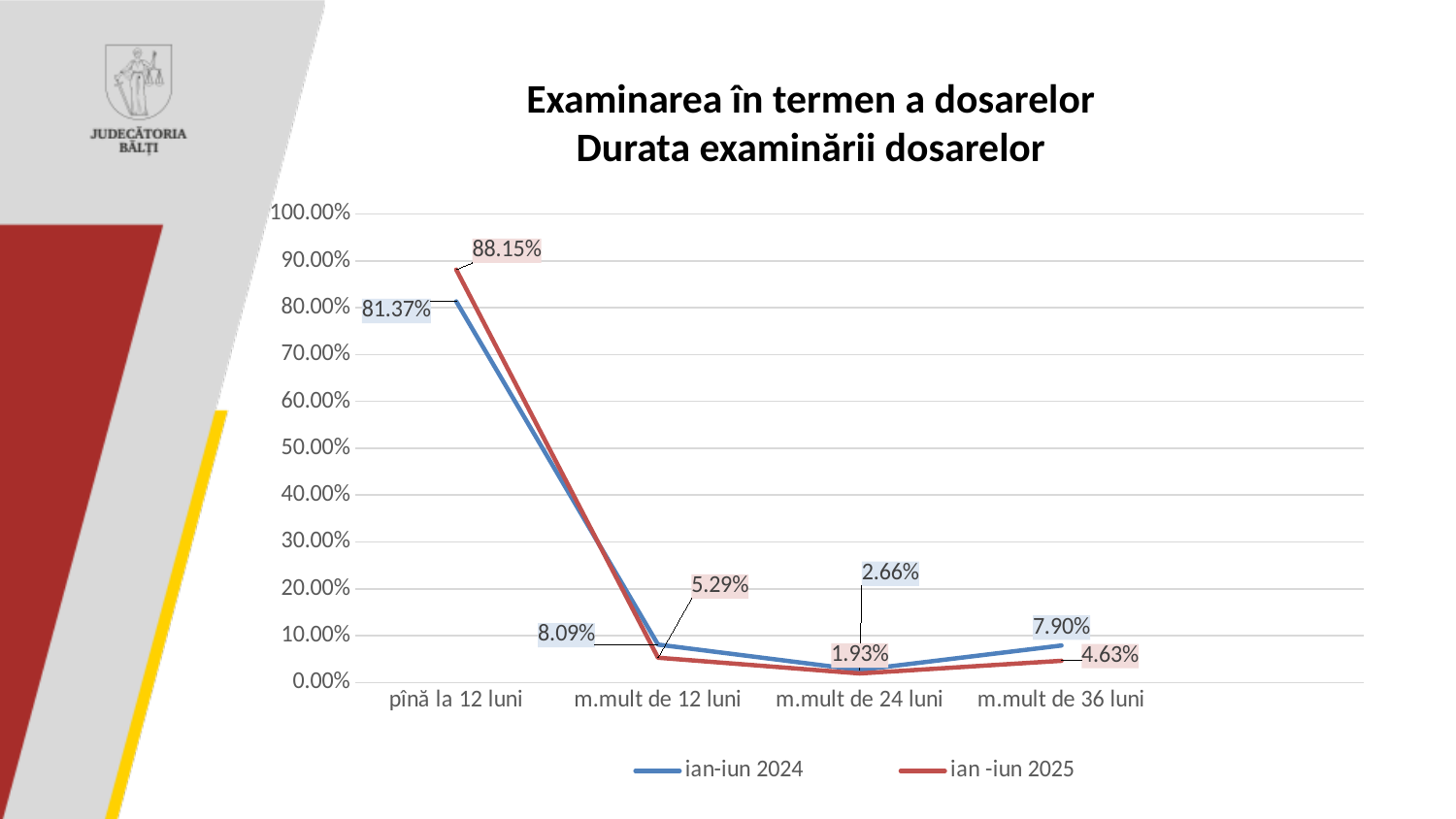
How many series does the legend list? 2 What kind of chart is shown on the slide? line chart What is the difference between the ian -iun 2025 and ian-iun 2024 values for 'pînă la 12 luni'? 6.78% What is the value for 'pînă la 12 luni' in the ian-iun 2024 series? 81.37% Which series has the larger value for 'm.mult de 12 luni', ian-iun 2024 or ian -iun 2025? ian-iun 2024 What is the value for 'pînă la 12 luni' in the ian -iun 2025 series? 88.15% What is the value for 'm.mult de 24 luni' in the ian -iun 2025 series? 1.93% What is the title of the chart? Examinarea în termen a dosarelor Durata examinării dosarelor How many categories are shown on the x axis? 4 Which category has the highest value in the ian -iun 2025 series? pînă la 12 luni What is the value for 'm.mult de 36 luni' in the ian-iun 2024 series? 7.90% Which category has the lowest value in the ian-iun 2024 series? m.mult de 24 luni